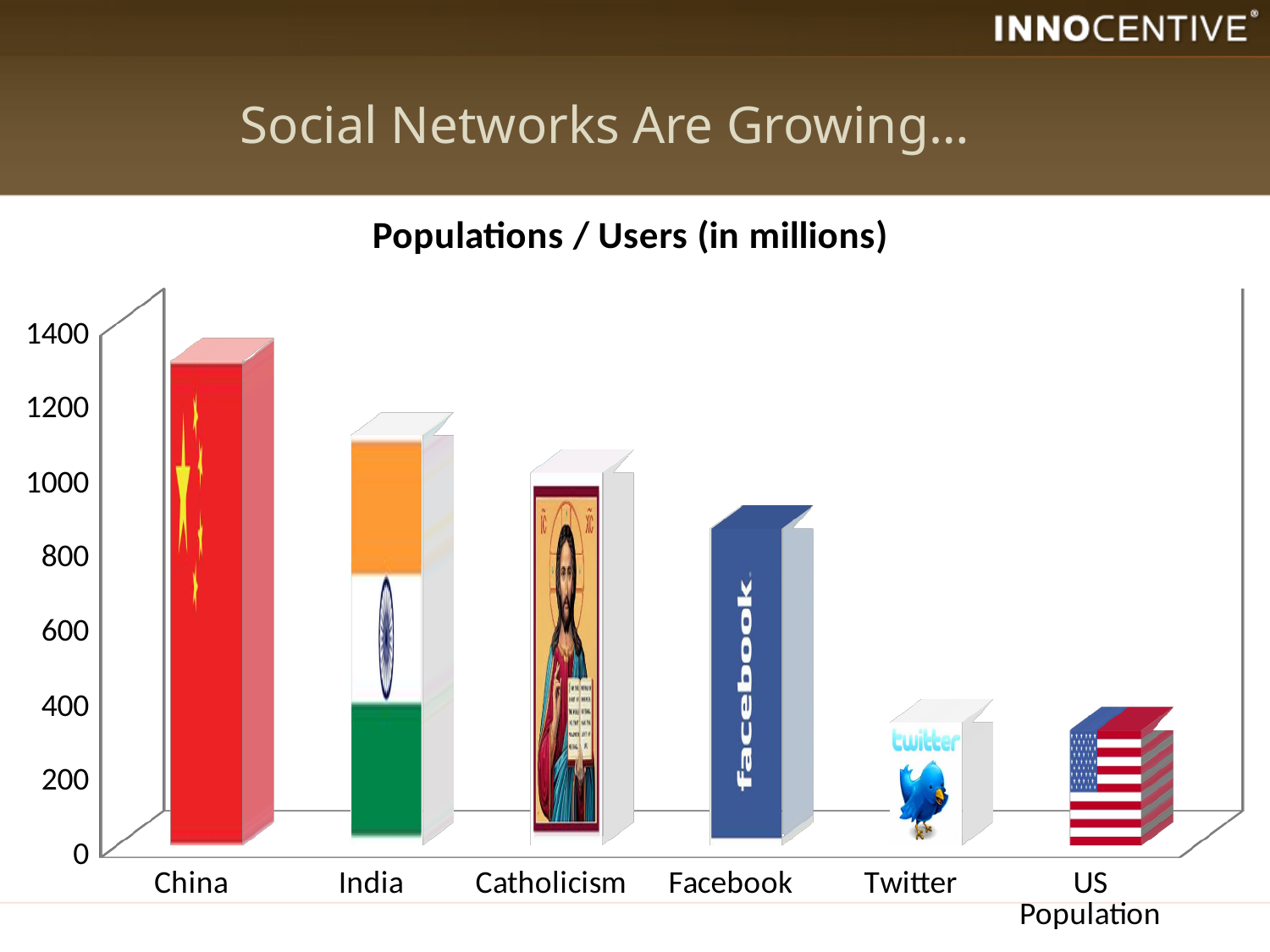
Which category has the highest value in the chart? China How many categories are shown on the x axis of the chart? 6 Is the value for India greater or less than 1000? greater Is the value for US Population greater or less than 600? less Is the value for Facebook greater or less than 1000? less Which is larger, the value for Catholicism or the value for Facebook? Catholicism What is the title of the chart? Populations / Users (in millions) Which is larger, the value for China or the value for India? China Which category has the lowest value in the chart? US Population What kind of chart is shown on the slide? bar chart